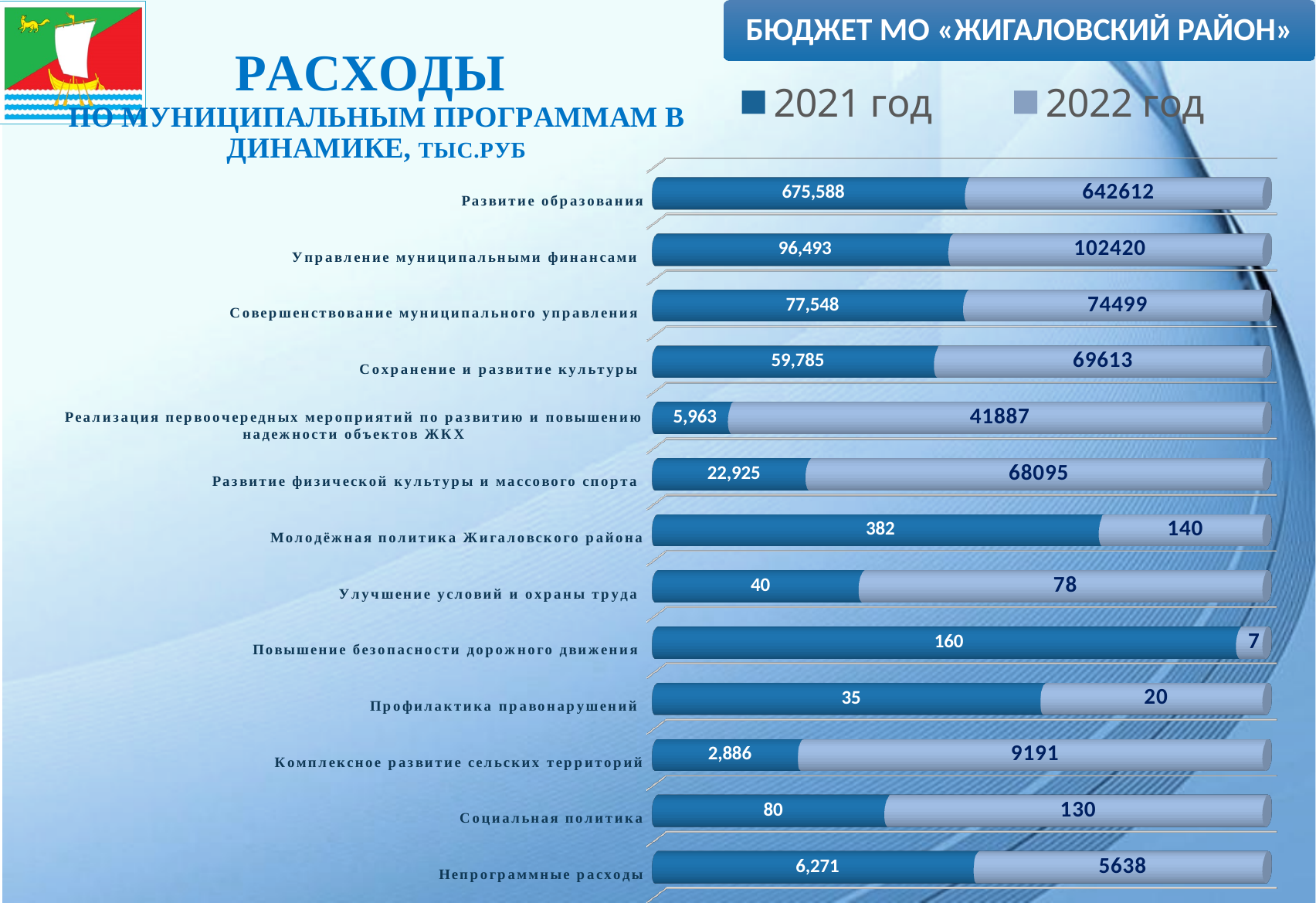
Which category has the highest 2021 год value? Развитие образования What is the difference between the 2022 год and 2021 год values for Социальная политика? 50 What is the 2022 год value for Реализация первоочередных мероприятий по развитию и повышению надежности объектов ЖКХ? 41887 What is the difference between the 2021 год and 2022 год values for Молодёжная политика Жигаловского района? 242 Which is larger for Сохранение и развитие культуры: the 2021 год value or the 2022 год value? 2022 год How many series does the legend list? 2 What is the 2021 год value for Развитие образования? 675,588 How many categories are shown in the chart? 13 What is the 2022 год value for Управление муниципальными финансами? 102420 What is the 2021 год value for Комплексное развитие сельских территорий? 2,886 What kind of chart is shown on the slide? Bar chart Which category has the lowest 2022 год value? Повышение безопасности дорожного движения